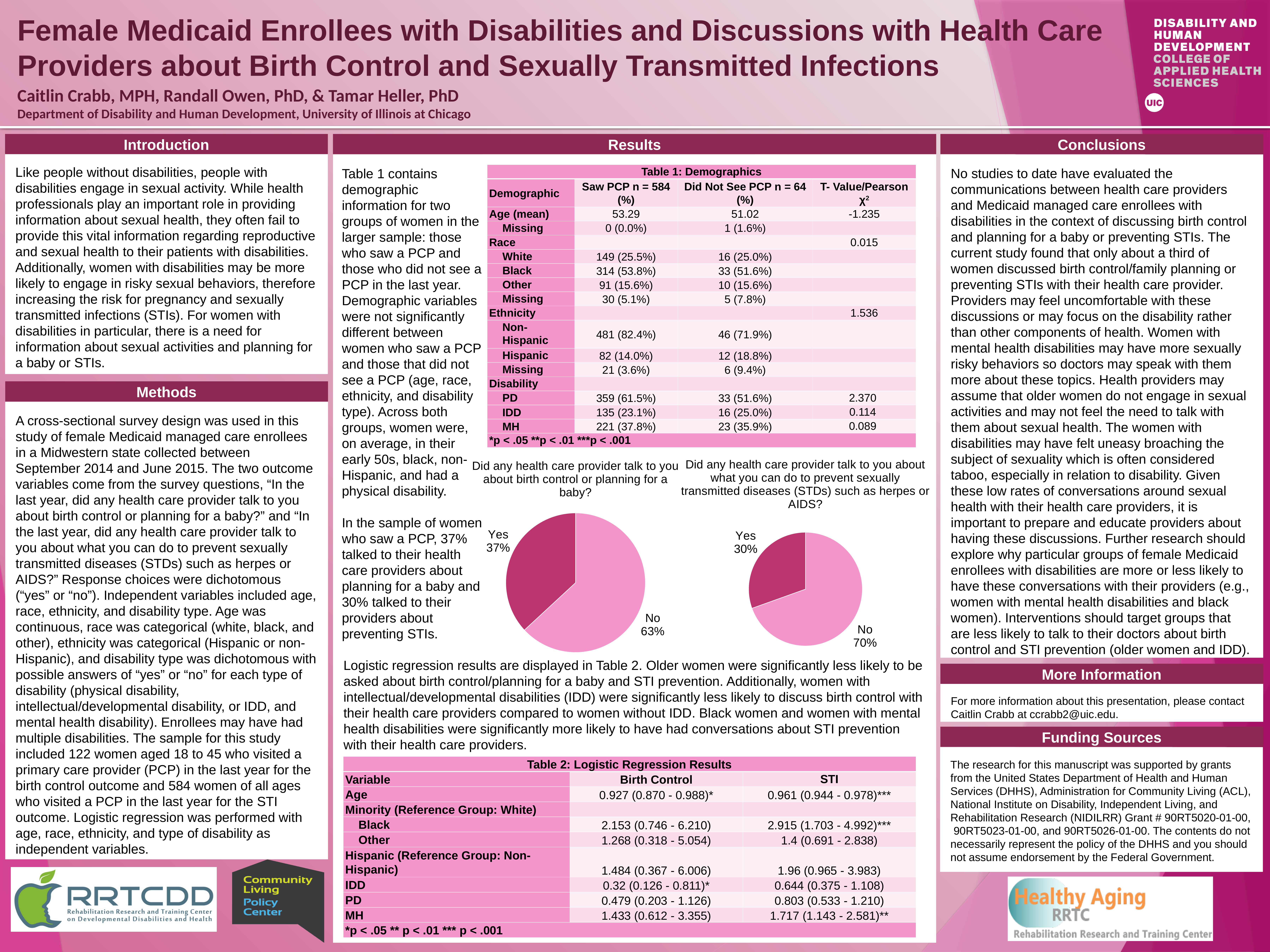
In the pie chart about preventing sexually transmitted diseases, what share of respondents answered Yes? 30% How many slices does the pie chart about preventing sexually transmitted diseases have? 2 In the pie chart about preventing sexually transmitted diseases, which response is the smallest slice? Yes In the pie chart about preventing sexually transmitted diseases, what is the difference in percentage points between the No and Yes slices? 40 In the pie chart about birth control or planning for a baby, what is the difference in percentage points between the No and Yes slices? 26 In the pie chart about birth control or planning for a baby, what share of respondents answered No? 63% In the pie chart about preventing sexually transmitted diseases, what share of respondents answered No? 70% What type of chart is used to show the responses about birth control or planning for a baby? Pie chart In the pie chart about birth control or planning for a baby, which response is the largest slice? No In the pie chart about birth control or planning for a baby, what share of respondents answered Yes? 37% How many pie charts are shown in the Results section of the slide? 2 Which pie chart has the larger Yes share: the one about birth control or planning for a baby, or the one about preventing sexually transmitted diseases? Birth control or planning for a baby